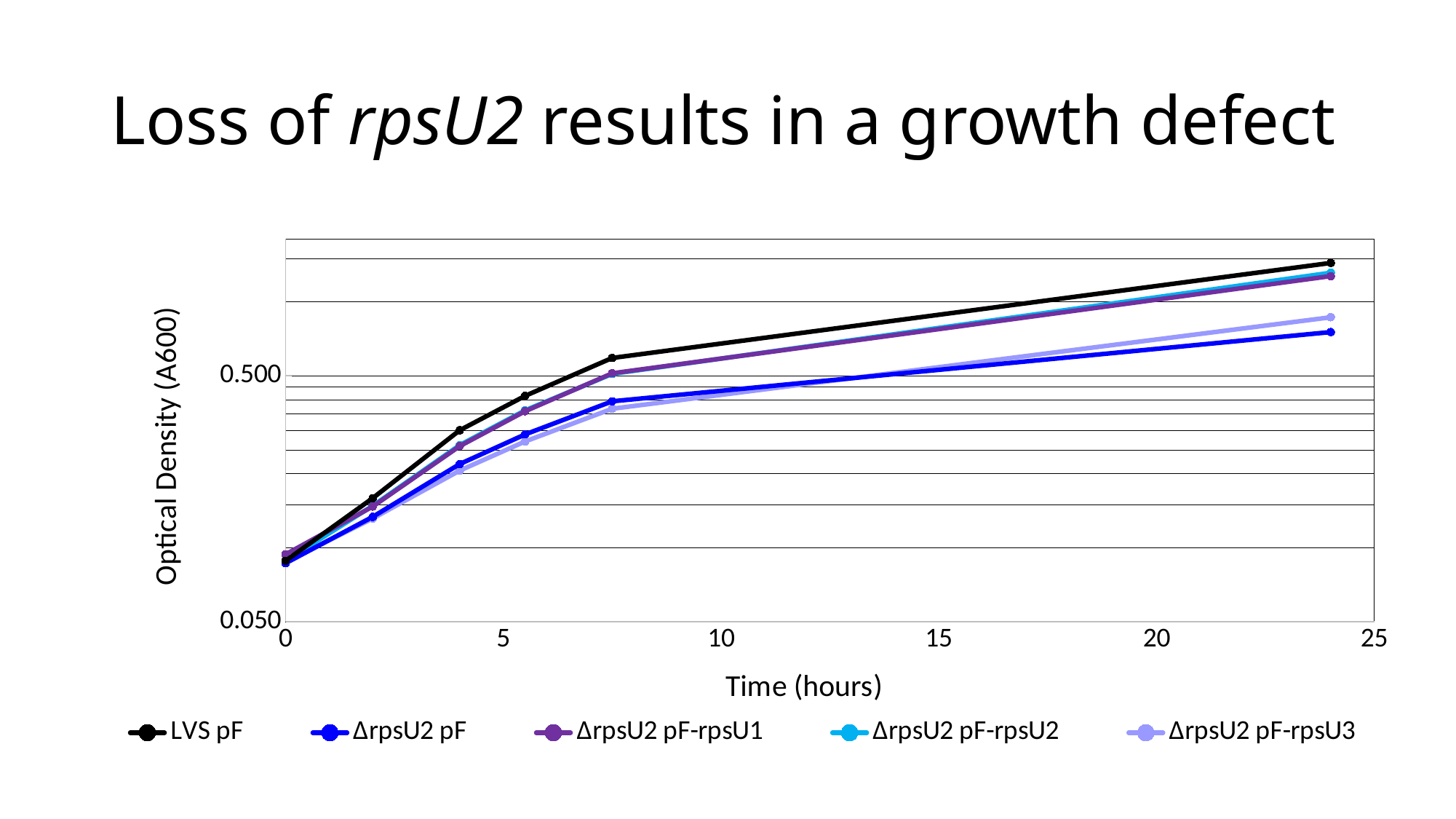
Do the optical density values rise or fall as time increases? rise Is the optical density for LVS pF at 24 hours greater or less than 0.500? greater What is the label of the x axis? Time (hours) How many time points are plotted for each series? 6 Which series has the highest optical density at 24 hours? LVS pF Is the optical density for ΔrpsU2 pF at 7.5 hours greater or less than 0.500? less Is the optical density for LVS pF at 0 hours greater or less than 0.500? less What kind of chart is shown on the slide? line chart How many series does the legend list? 5 At 24 hours, which series has the larger optical density, LVS pF or ΔrpsU2 pF? LVS pF What is the label of the y axis? Optical Density (A600) Which series has the lowest optical density at 24 hours? ΔrpsU2 pF